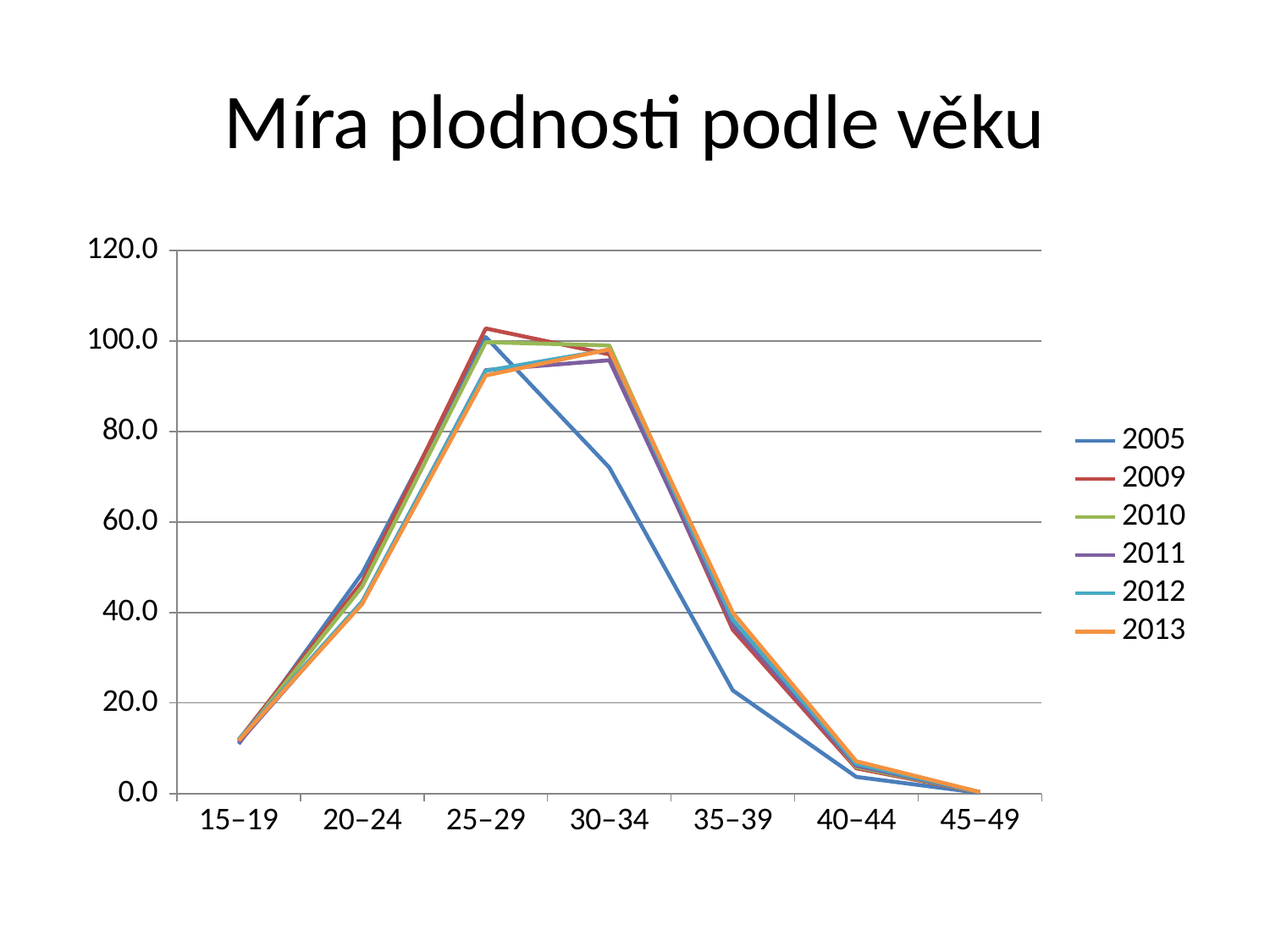
Do the values for the 2005 series rise or fall from 30–34 to 45–49? fall How many series does the legend list? 6 Is the value for 2005 at 20–24 greater or less than 40? greater What kind of chart is shown on the slide? line chart Is the value for 2005 at 30–34 greater or less than 80? less How many age categories are shown on the x axis? 7 Which year is listed first in the legend? 2005 What is the title of the chart? Míra plodnosti podle věku For the 2013 series, which age category has the lowest value? 45–49 At 30–34, which series has the larger value, 2005 or 2013? 2013 For the 2005 series, which age category has the highest value? 25–29 Is the value for 2013 at 40–44 greater or less than 20? less